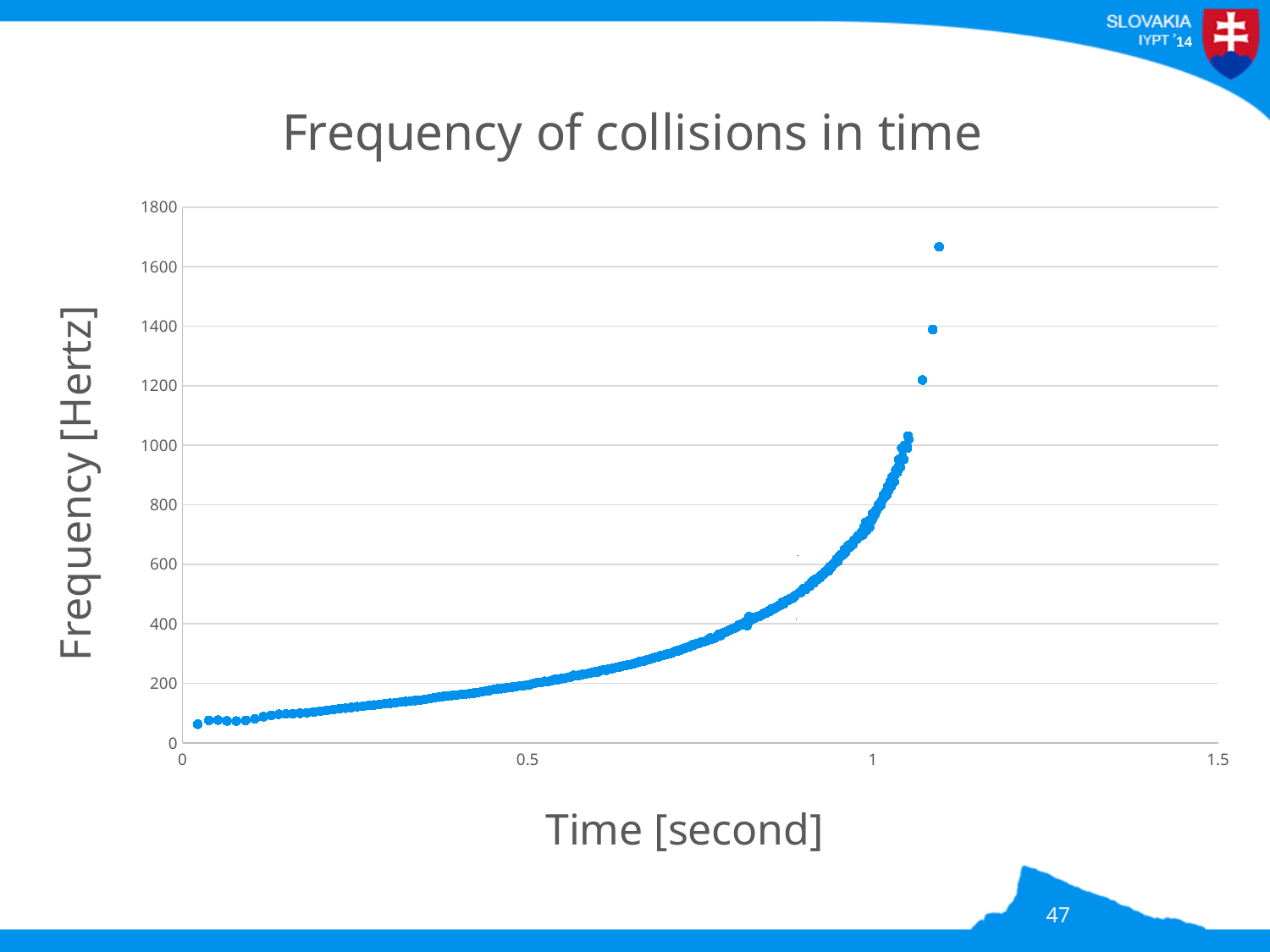
What is the title of the chart? Frequency of collisions in time What kind of chart is shown on the slide? scatter plot Does the frequency rise or fall as time increases along the x axis? rise Is the frequency of the first plotted point (near time 0) greater or less than 200 Hertz? less Is the highest plotted frequency greater or less than 1600 Hertz? greater Which is larger, the frequency at time 0.5 seconds or the frequency at time 1 second? time 1 second Is the frequency at time 1 second greater or less than 600 Hertz? greater What is the label of the y axis? Frequency [Hertz] What is the maximum value shown on the x axis? 1.5